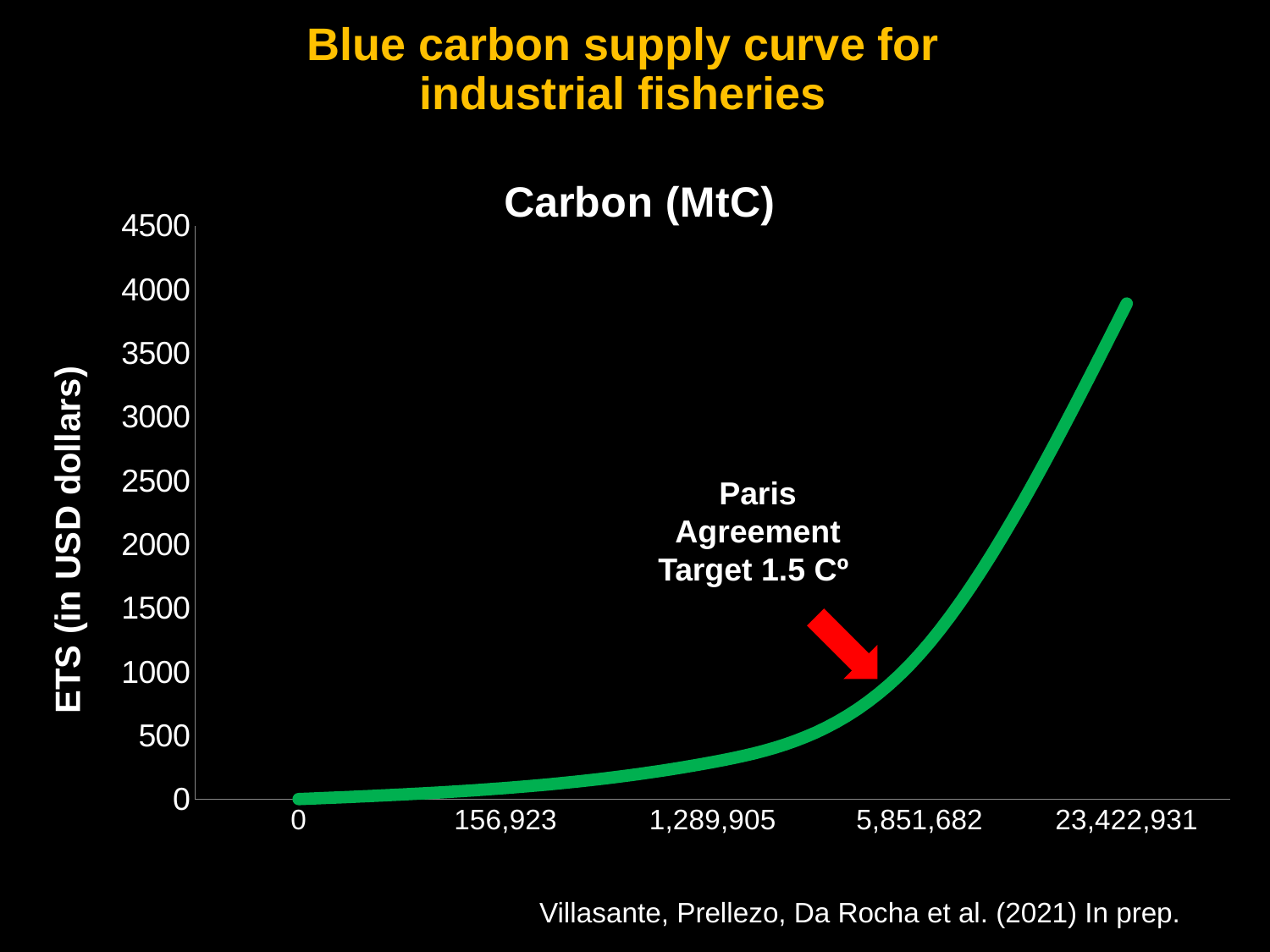
Is the ETS value at Carbon 23,422,931 MtC greater or less than 3500? greater Which has the larger ETS value: Carbon 156,923 MtC or Carbon 23,422,931 MtC? 23,422,931 What kind of chart is shown on the slide? Line chart What is the label of the y axis? ETS (in USD dollars) At which Carbon (MtC) value is the ETS value lowest? 0 Does the ETS value rise or fall as Carbon (MtC) increases along the x axis? Rises What is the title of the chart on the slide? Carbon (MtC) How many tick labels are shown on the x axis? 5 Is the ETS value at Carbon 1,289,905 MtC greater or less than 500? less At which Carbon (MtC) value is the ETS value highest? 23,422,931 Is the ETS value at Carbon 5,851,682 MtC greater or less than 1500? less